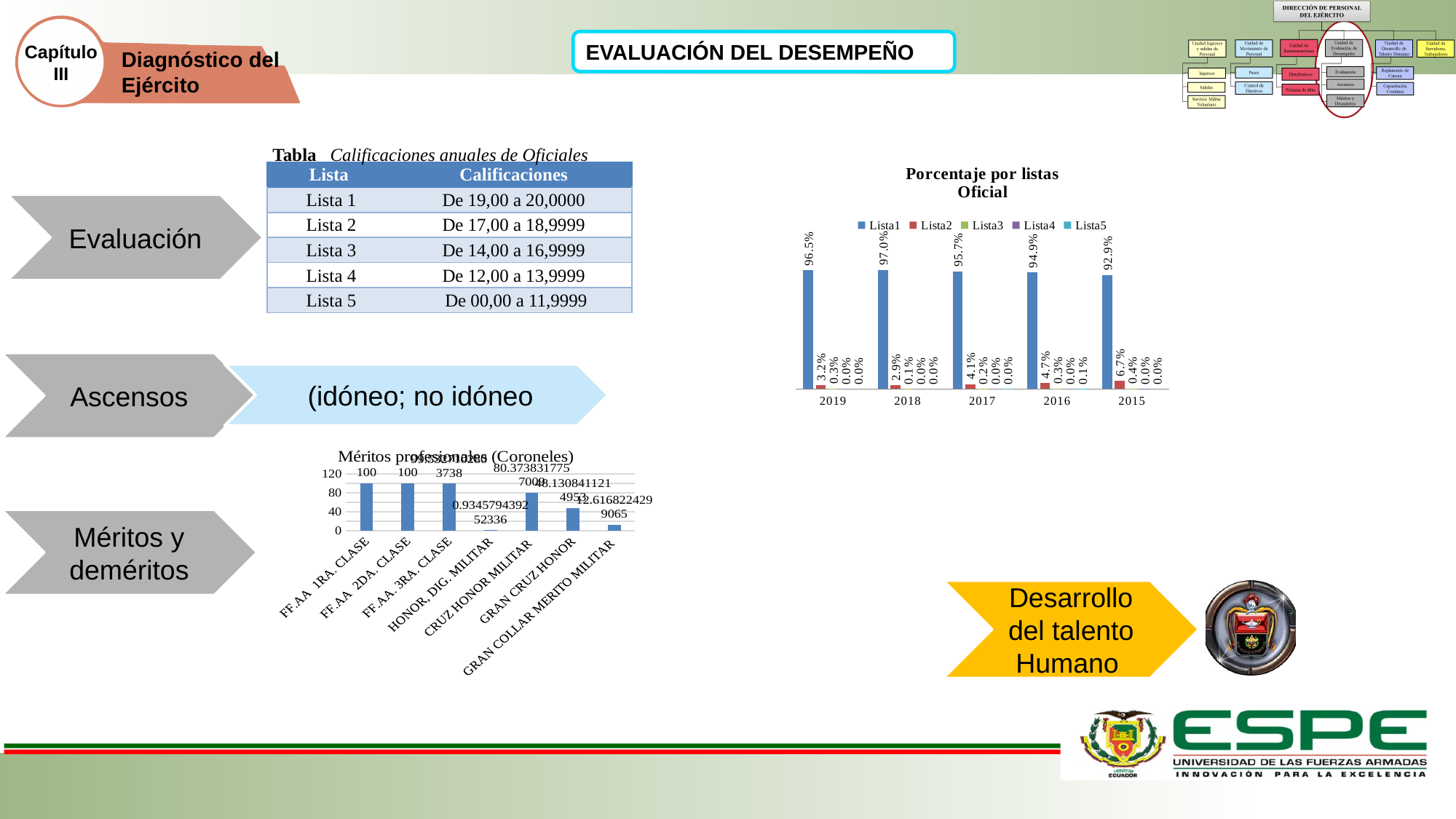
In the 'Porcentaje por listas Oficial' chart, which year has the lowest Lista1 value? 2015 In the 'Porcentaje por listas Oficial' chart, is the Lista2 value larger in 2016 or in 2017? 2016 How many series does the legend of the 'Porcentaje por listas Oficial' chart list? 5 In the 'Porcentaje por listas Oficial' chart, which year has the highest Lista1 value? 2018 In the 'Porcentaje por listas Oficial' chart, what is the value for Lista2 in 2015? 6.7% In the 'Porcentaje por listas Oficial' chart, what is the value for Lista1 in 2019? 96.5% In the 'Porcentaje por listas Oficial' chart, what is the difference between the Lista1 values for 2018 and 2015? 4.1% In the 'Méritos profesionales (Coroneles)' chart, what is the value for FF.AA 1RA. CLASE? 100 How many years are shown on the x axis of the 'Porcentaje por listas Oficial' chart? 5 What kind of chart is 'Méritos profesionales (Coroneles)'? Bar chart In the 'Porcentaje por listas Oficial' chart, what is the value for Lista1 in 2018? 97.0% In the 'Méritos profesionales (Coroneles)' chart, is the value for GRAN COLLAR MERITO MILITAR greater or less than 40? less